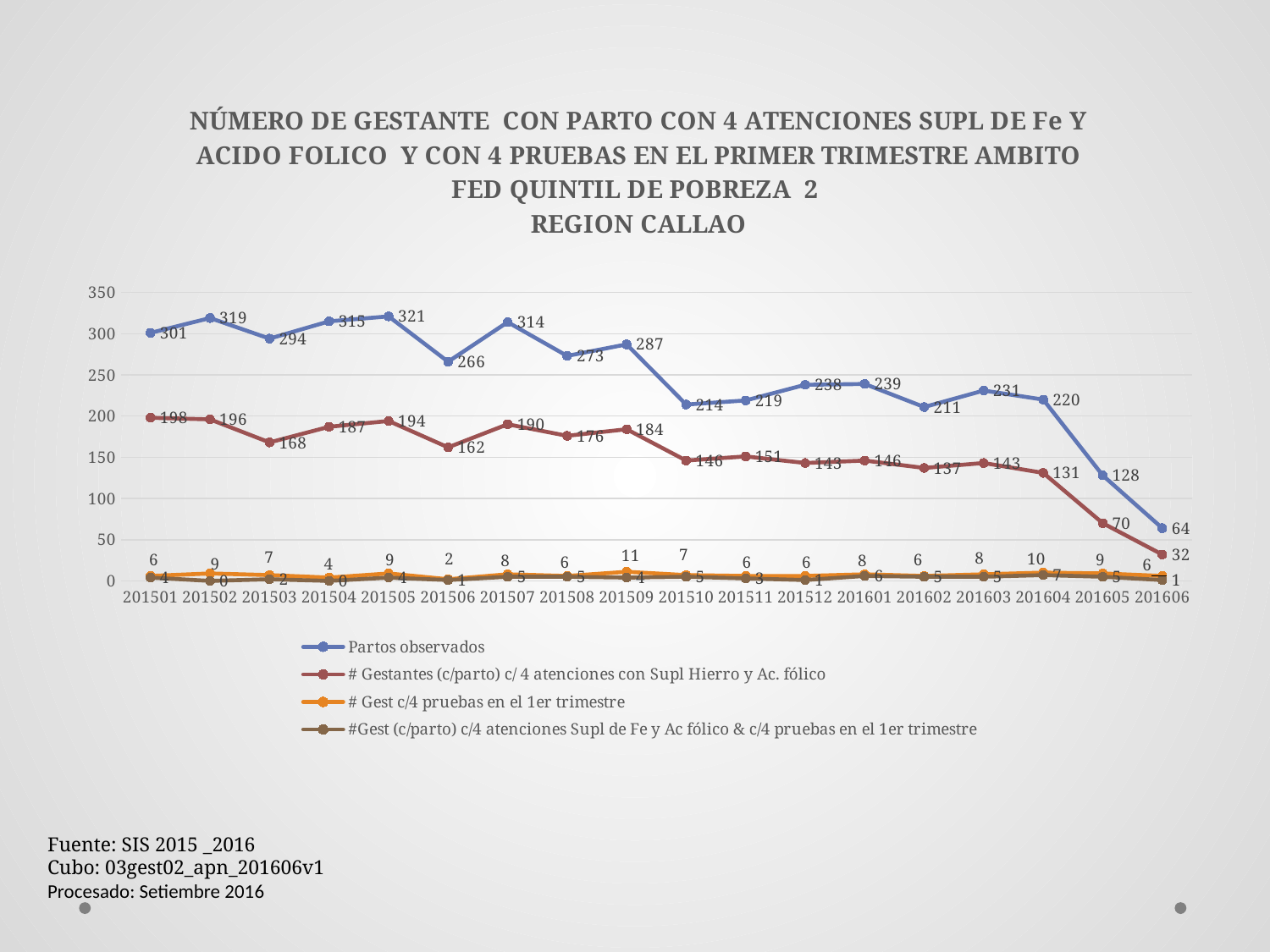
What is the difference between Partos observados in 201501 and in 201606? 237 What is the value of Partos observados for 201505? 321 Does Partos observados generally rise or fall from 201501 to 201606? Fall What is the value of # Gest c/4 pruebas en el 1er trimestre for 201509? 11 What is the difference between # Gestantes (c/parto) c/ 4 atenciones con Supl Hierro y Ac. fólico in 201605 and in 201606? 38 What kind of chart is shown on the slide? Line chart In which period is Partos observados lowest? 201606 In which period is Partos observados highest? 201505 Which period has the larger value of Partos observados, 201502 or 201507? 201502 What is the value of # Gestantes (c/parto) c/ 4 atenciones con Supl Hierro y Ac. fólico for 201601? 146 How many periods are shown on the x axis? 18 How many series does the legend list? 4